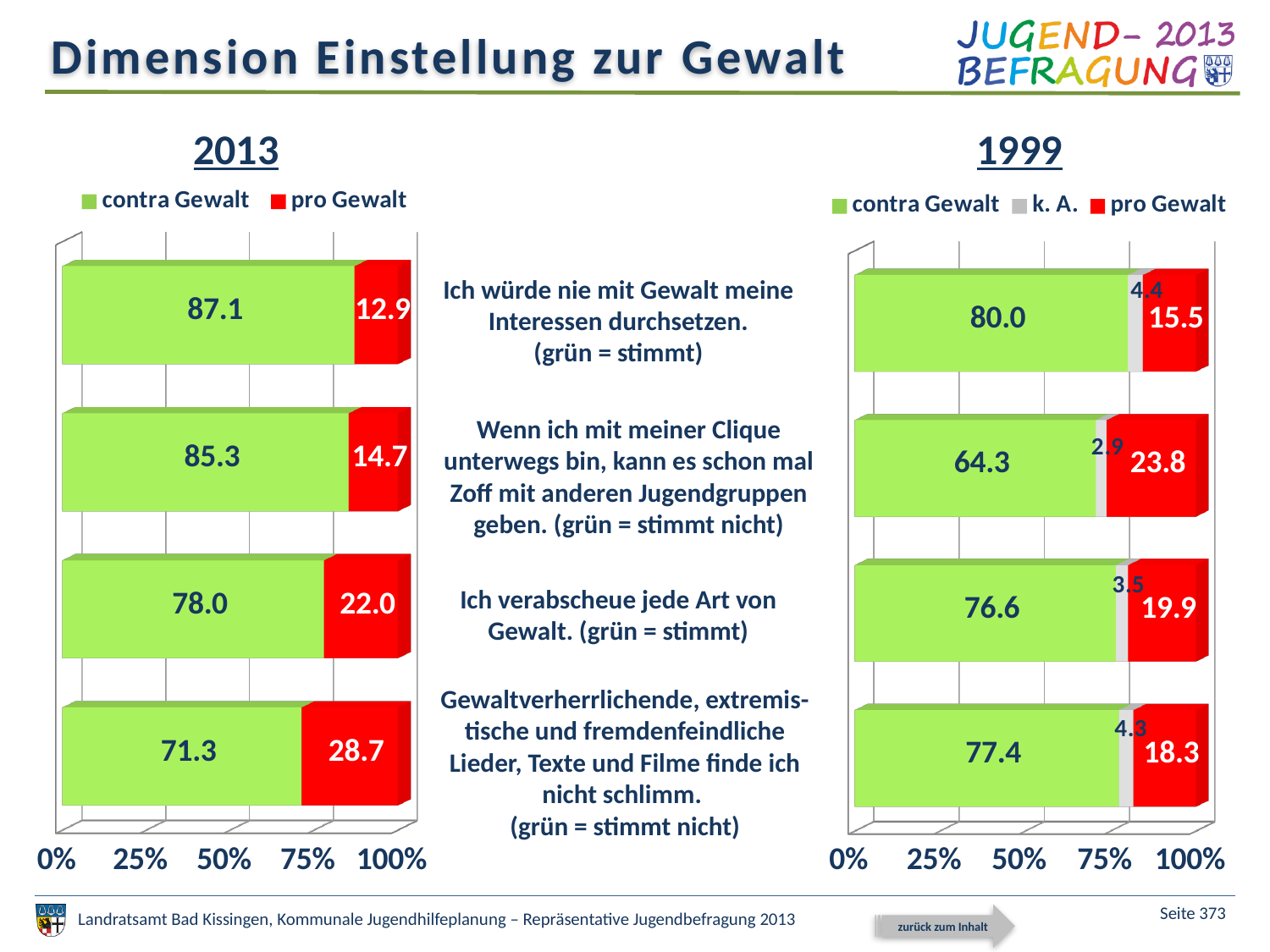
Which is larger: the 'contra Gewalt' value for 'Ich verabscheue jede Art von Gewalt' in the 2013 chart or in the 1999 chart? 2013 (78.0) How many series does the legend of the 2013 chart list? 2 In the 1999 chart, what is the 'k. A.' value for the statement 'Ich verabscheue jede Art von Gewalt'? 3.5 In the 2013 chart, what is the 'contra Gewalt' value for the statement 'Ich würde nie mit Gewalt meine Interessen durchsetzen'? 87.1 What kind of chart is the 2013 chart? Stacked bar chart How many series does the legend of the 1999 chart list? 3 How many statements (bars) are shown in the 1999 chart? 4 In the 2013 chart, which statement has the highest 'pro Gewalt' value? Gewaltverherrlichende, extremistische und fremdenfeindliche Lieder, Texte und Filme finde ich nicht schlimm. In the 2013 chart, what is the difference between the 'contra Gewalt' and 'pro Gewalt' values for the statement 'Ich verabscheue jede Art von Gewalt'? 56.0 In the 1999 chart, which statement has the lowest 'contra Gewalt' value? Wenn ich mit meiner Clique unterwegs bin, kann es schon mal Zoff mit anderen Jugendgruppen geben. In the 1999 chart, what is the total of the 'contra Gewalt', 'k. A.' and 'pro Gewalt' values for the statement 'Gewaltverherrlichende, extremistische und fremdenfeindliche Lieder, Texte und Filme finde ich nicht schlimm'? 100.0 In the 1999 chart, what is the 'pro Gewalt' value for the statement 'Wenn ich mit meiner Clique unterwegs bin, kann es schon mal Zoff mit anderen Jugendgruppen geben'? 23.8